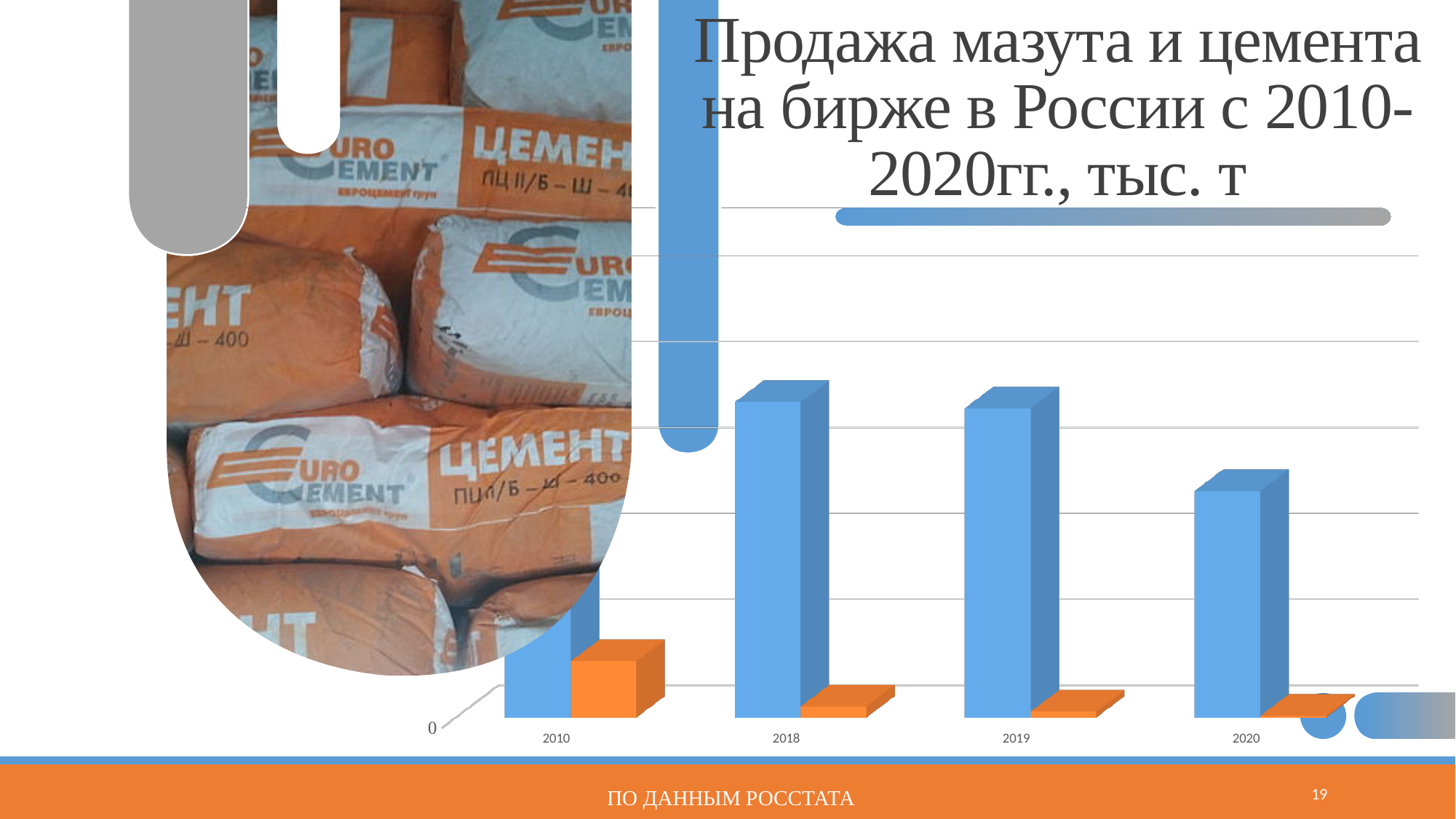
Which is larger, the orange bar for 2010 or the orange bar for 2019? 2010 Which years are shown as categories on the x axis? 2010, 2018, 2019, 2020 Does the orange series rise or fall from 2010 to 2018? fall How many bar series (colours) are plotted in the chart? 2 In which year is the orange bar the highest? 2010 How many year categories are shown on the x axis of the chart? 4 What is the title of the chart on the slide? Продажа мазута и цемента на бирже в России с 2010-2020гг., тыс. т Which is larger in 2018, the blue bar or the orange bar? the blue bar Which is larger, the blue bar for 2019 or the blue bar for 2020? 2019 What kind of chart is shown on the slide? bar chart